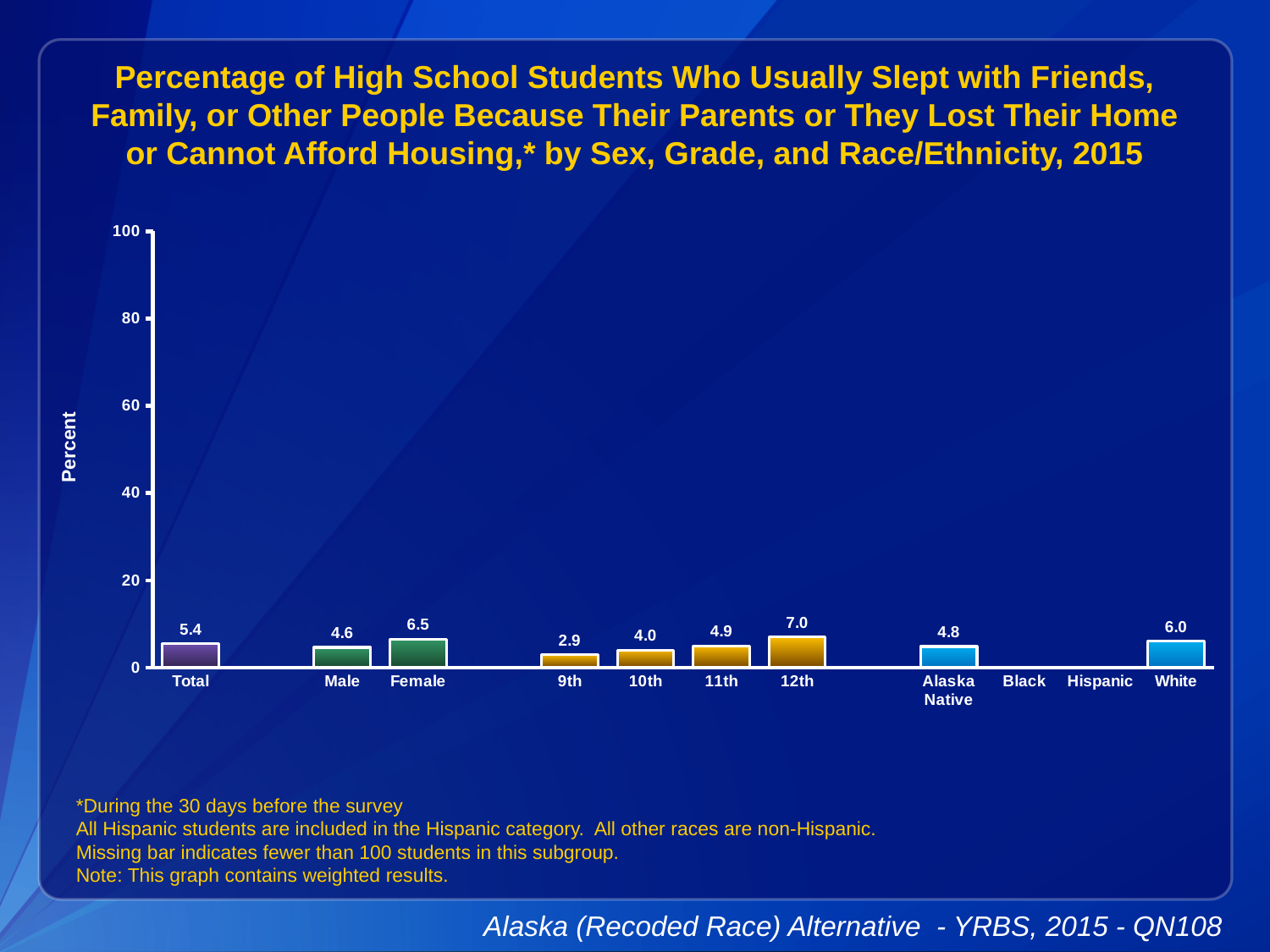
What is the value for White? 6.0 What kind of chart is shown? bar chart Which is larger, the value for 11th grade or the value for 10th grade? 11th Which grade has the highest value? 12th Is the value for 12th grade greater or less than 20? less What is the value for Total? 5.4 What is the value for Female? 6.5 What is the value for 9th grade? 2.9 Do the values rise or fall from 9th grade to 12th grade? rise What is the difference between the Female and Male values? 1.9 How many categories have a bar shown on the chart? 9 Which category has the lowest value among those with bars shown? 9th